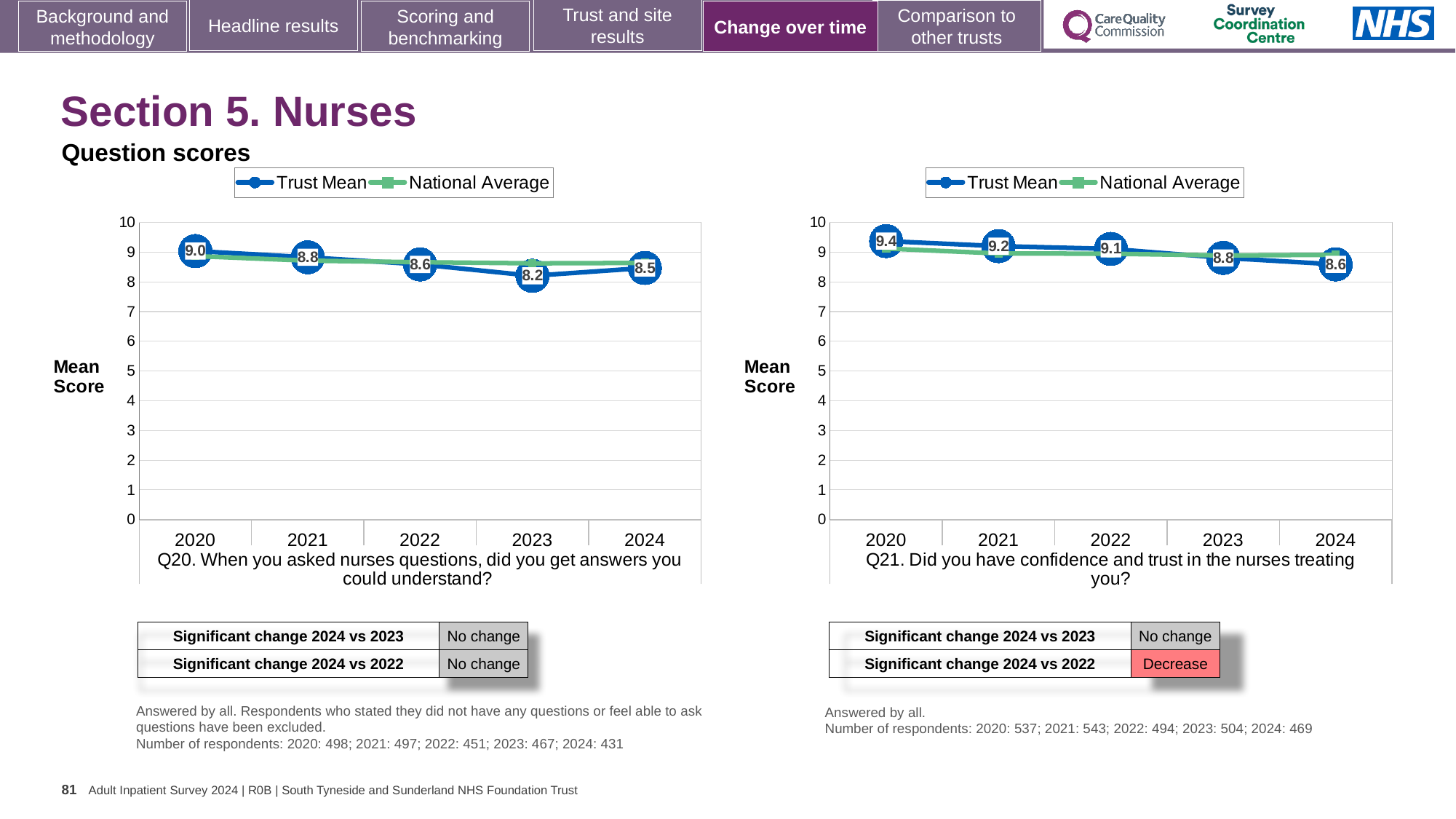
In the Q21 chart, is the Trust Mean score for 2022 greater or less than 8? greater In the Q20 chart, how many years are plotted on the x axis? 5 How many series does the legend of the Q20 chart list? 2 In the Q20 chart, what is the difference between the Trust Mean scores for 2020 and 2024? 0.5 In the Q20 chart, what is the Trust Mean score for 2020? 9.0 In the Q21 chart, which year has the highest Trust Mean score? 2020 What type of chart is used for Q21? line chart In the Q21 chart, what is the Trust Mean score for 2024? 8.6 In the Q20 chart, which year has the lowest Trust Mean score? 2023 In the Q21 chart, what is the difference between the Trust Mean scores for 2021 and 2023? 0.4 In the Q21 chart, does the Trust Mean rise or fall from 2020 to 2024? fall In the Q20 chart, what is the Trust Mean score for 2023? 8.2